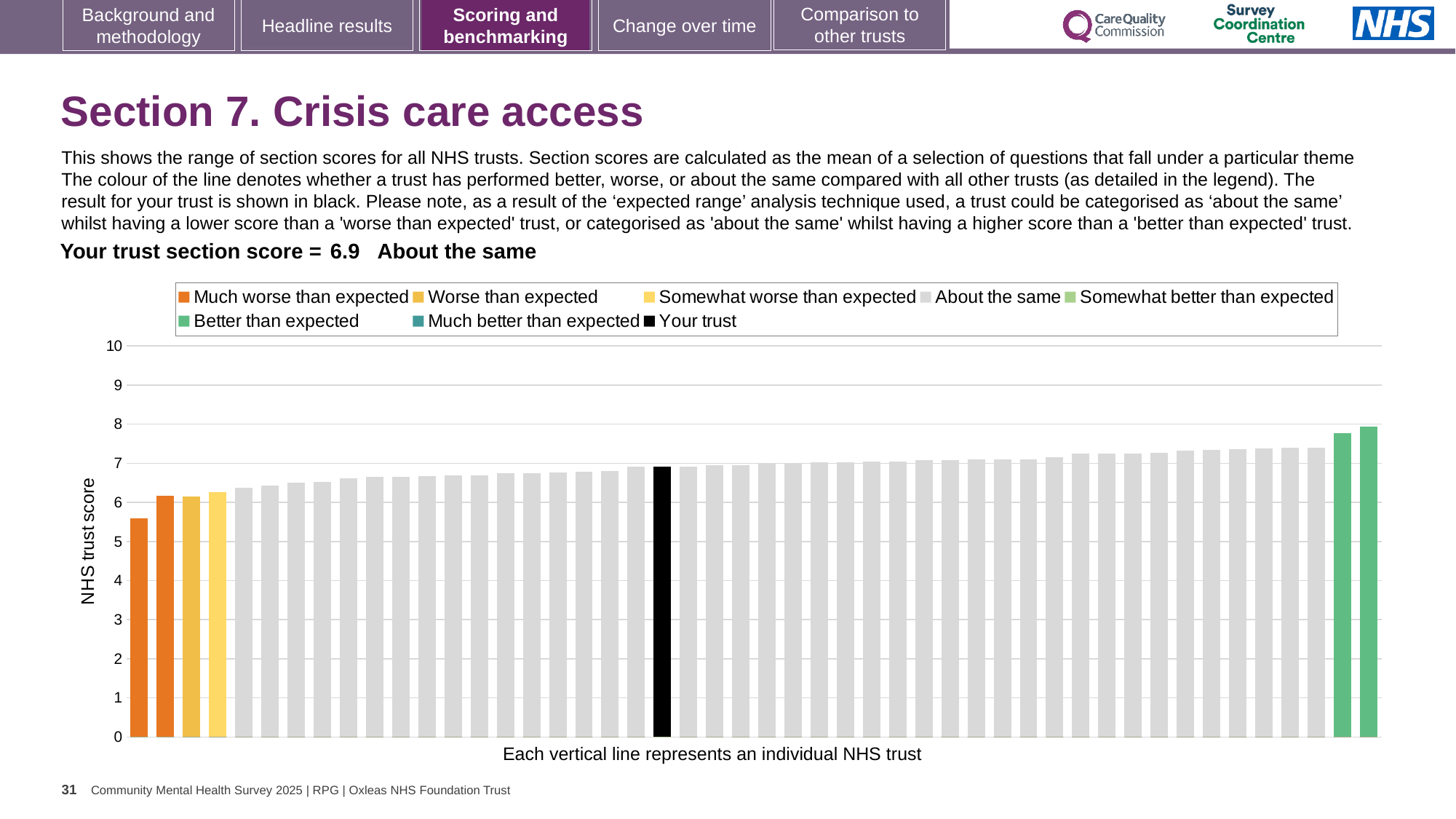
What is the label on the vertical axis of the chart? NHS trust score What kind of chart is shown on the slide? bar chart Is the value for the black 'Your trust' bar greater or less than 6? greater How many entries does the chart legend list? 8 Which legend category does the lowest bar belong to? Much worse than expected Which category is your trust placed in for this section? About the same Do the bar values rise or fall from left to right along the x axis? rise Is the value for the rightmost (highest) bar greater or less than 7? greater How many green 'Better than expected' bars are shown in the chart? 2 Is the value for the leftmost (lowest) bar greater or less than 6? less Which legend category does the highest bar belong to? Better than expected What is the section score for your trust shown on the slide? 6.9